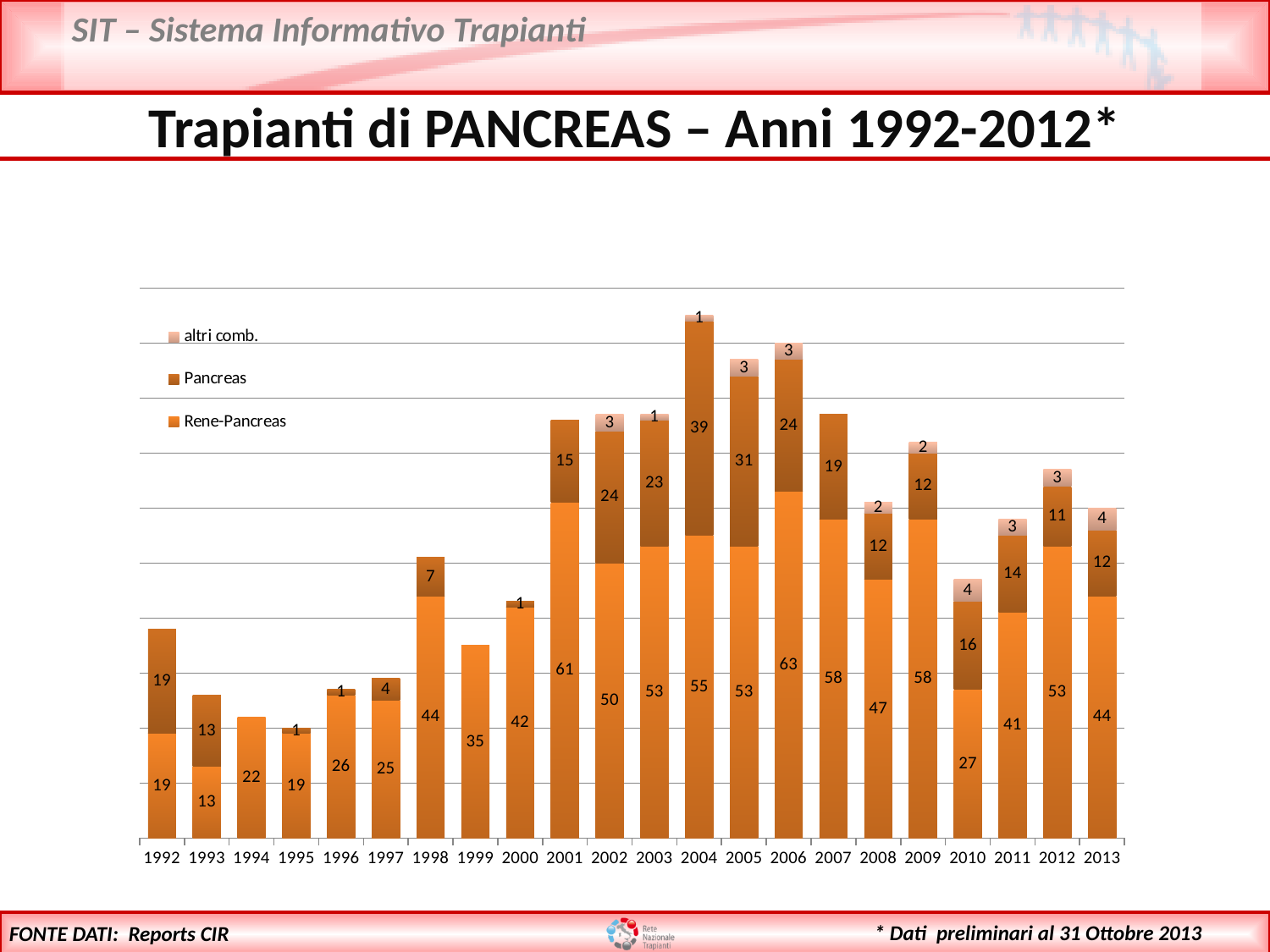
How many years are shown on the x axis? 22 How many series does the legend list? 3 Which year has the lowest Rene-Pancreas value? 1993 What is the Rene-Pancreas value for 2006? 63 What is the total of the stacked bar for 2013? 60 Which is larger, the Pancreas value for 2002 or for 2003? 2002 What kind of chart is shown on the slide? Stacked bar chart What is the total of the stacked bar for 2004? 95 Which year has the highest Rene-Pancreas value? 2006 What is the altri comb. value for 2013? 4 What is the Pancreas value for 2004? 39 What is the difference between the Rene-Pancreas values for 2001 and 2000? 19